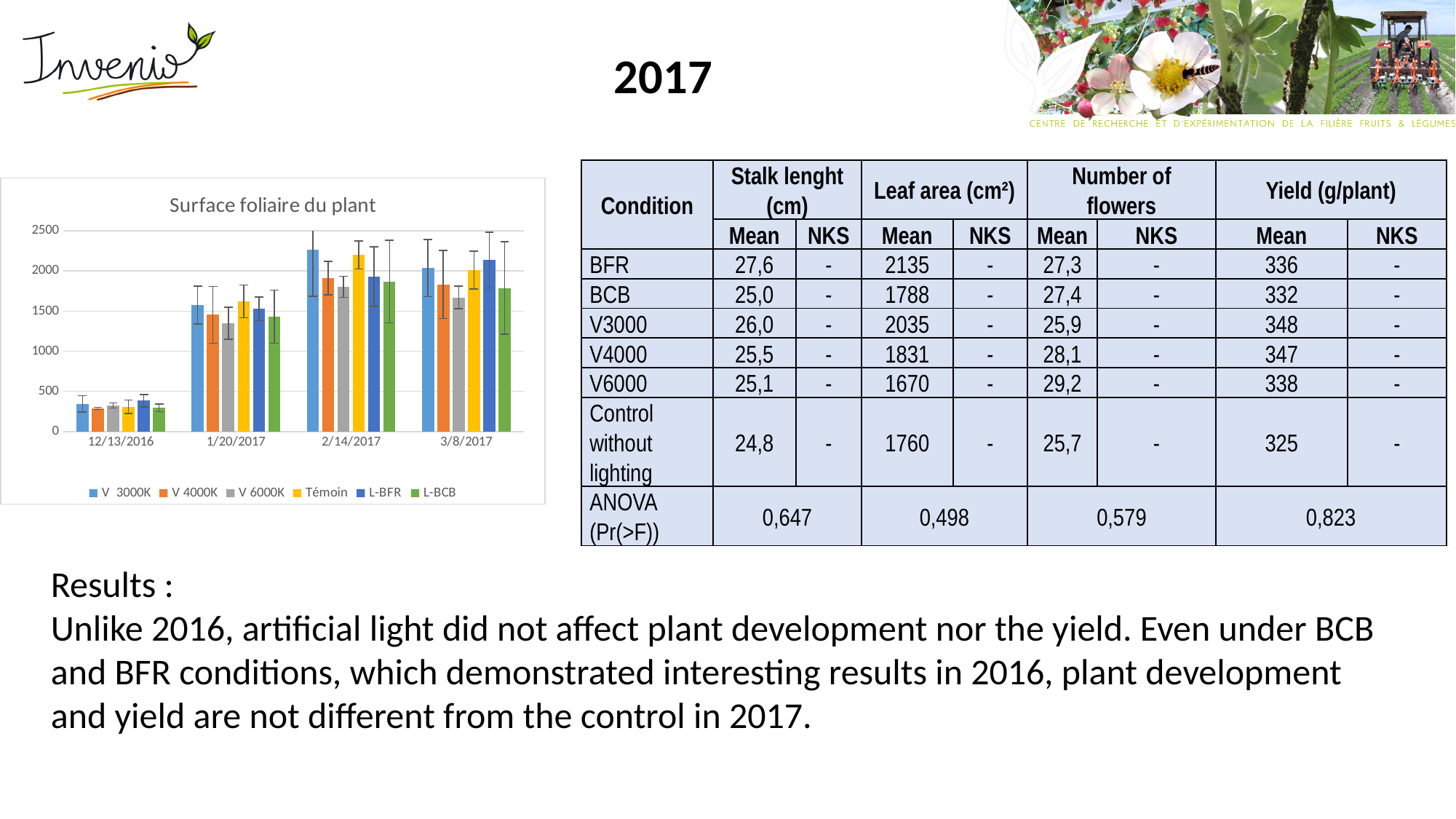
What is the title of the chart on the slide? Surface foliaire du plant How many series does the chart's legend list? 6 Which date category has the lowest bars in the chart? 12/13/2016 Do the V 3000K values rise or fall from 12/13/2016 to 2/14/2017? rise Is the value for L-BFR at 12/13/2016 greater or less than 500? less Is the value for V 6000K at 1/20/2017 greater or less than 1500? less How many date categories are shown on the x axis of the chart? 4 Is the value for V 3000K at 2/14/2017 greater or less than 2000? greater Which is larger at 2/14/2017: the value for V 3000K or the value for V 6000K? V 3000K What kind of chart is shown on the slide? bar chart Which legend entry is shown in yellow in the chart? Témoin